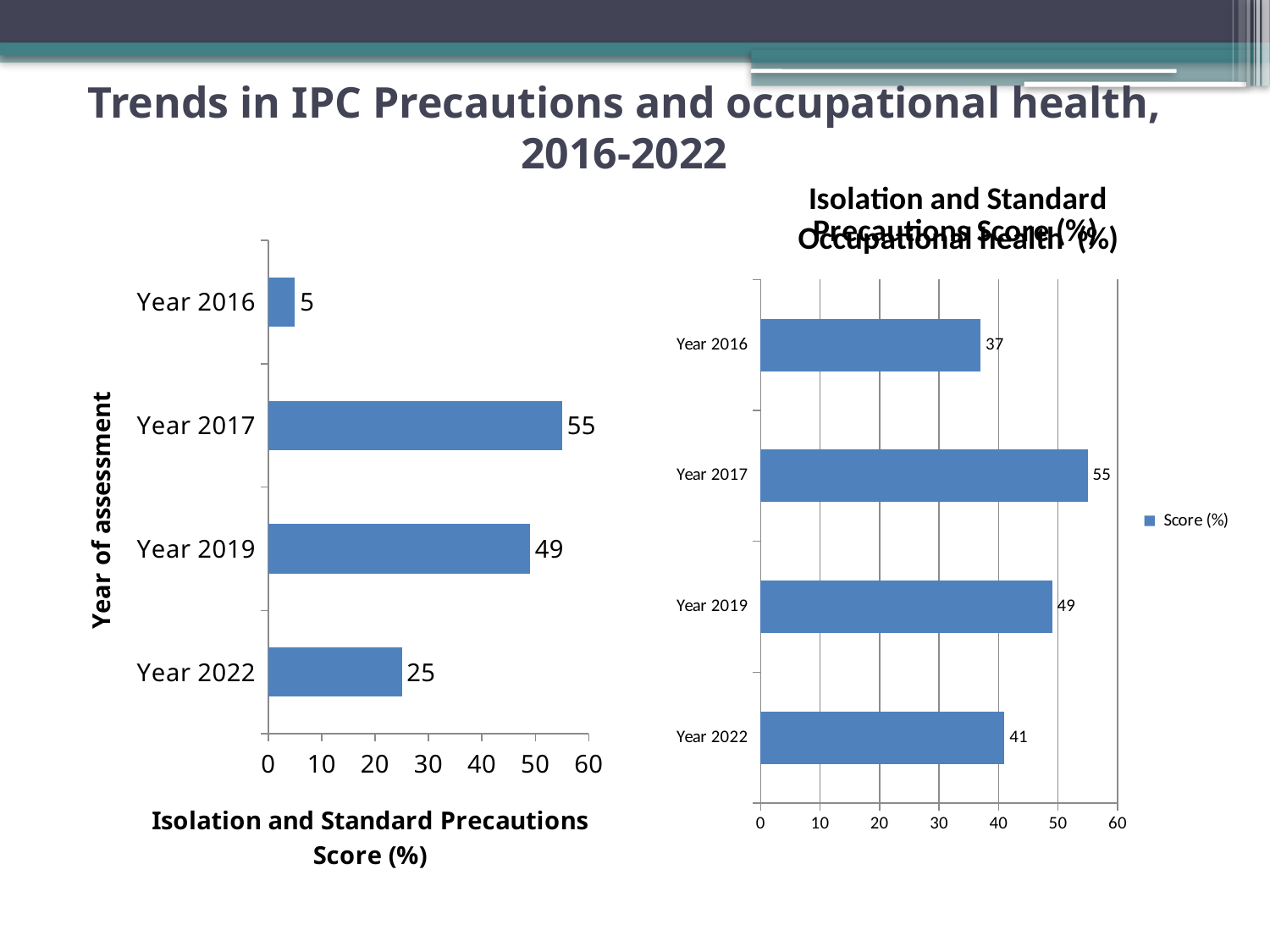
In the left chart, which year has the highest value? Year 2017 In the left chart, what is the value for Year 2022? 25 How many years are shown in the left chart? 4 What kind of chart is the left chart? Bar chart In the left chart, what is the difference between the values for Year 2017 and Year 2022? 30 In the right chart, what is the value for Year 2016? 37 In the left chart, which year has the lowest value? Year 2016 In the right chart, which is larger, the value for Year 2019 or the value for Year 2022? Year 2019 In the right chart, what is the difference between the values for Year 2022 and Year 2016? 4 In the right chart, which year has the highest value? Year 2017 In the right chart, what is the value for Year 2022? 41 In the left chart, what is the value for Year 2017? 55